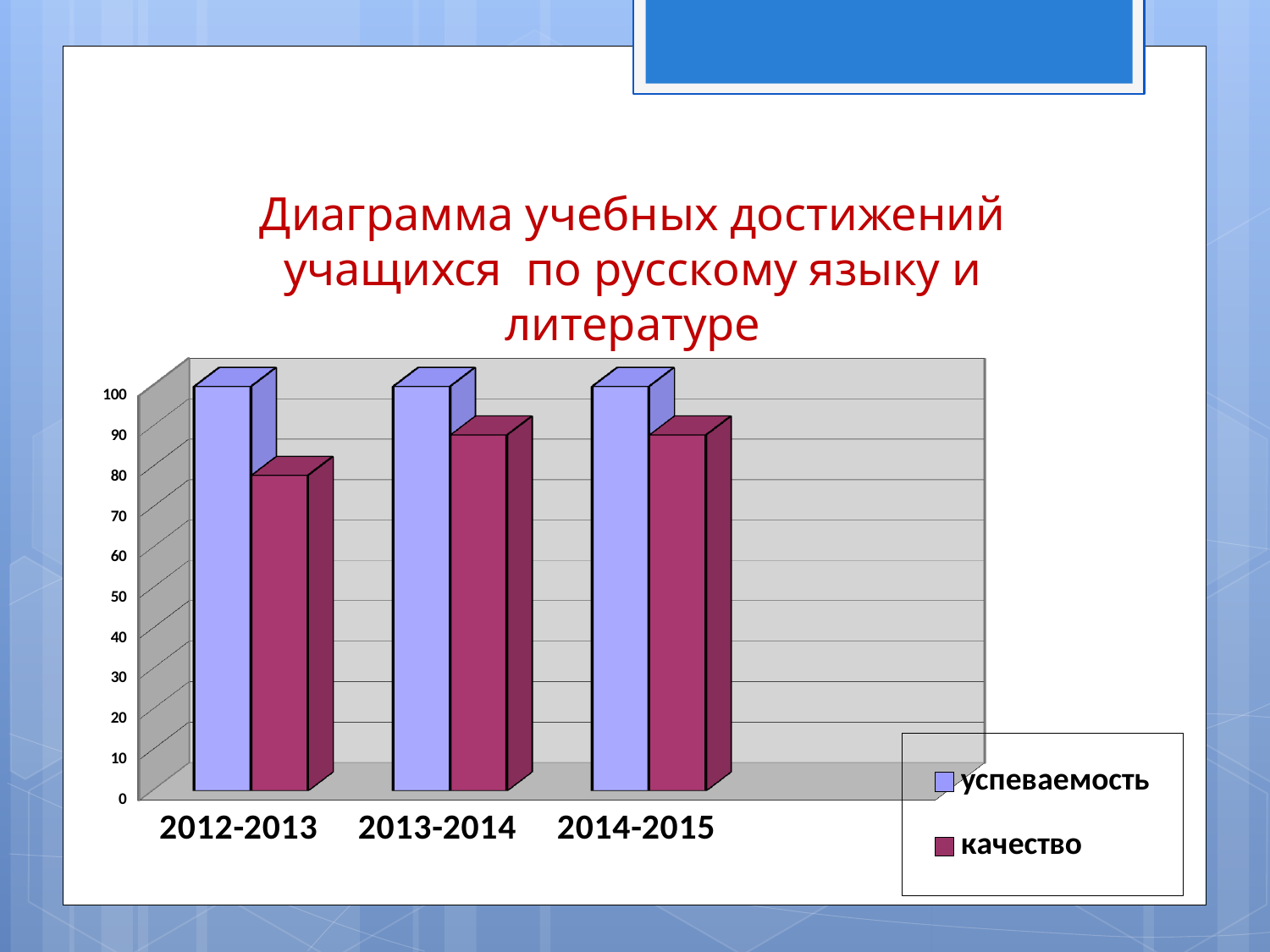
What kind of chart is shown on the slide? bar chart In which academic year is качество the lowest? 2012-2013 How many series does the legend list? 2 Is the value of качество for 2014-2015 greater or less than 80? greater How many academic years (categories) are shown on the x axis? 3 Does качество rise or fall from 2012-2013 to 2013-2014? rise What are the two series named in the legend? успеваемость, качество Is the value of качество for 2013-2014 greater or less than 80? greater Which colour represents the series качество? magenta (dark pink) What is the value of успеваемость for 2013-2014? 100 In 2012-2013, which is larger: успеваемость or качество? успеваемость Is the value of качество for 2012-2013 greater or less than 90? less